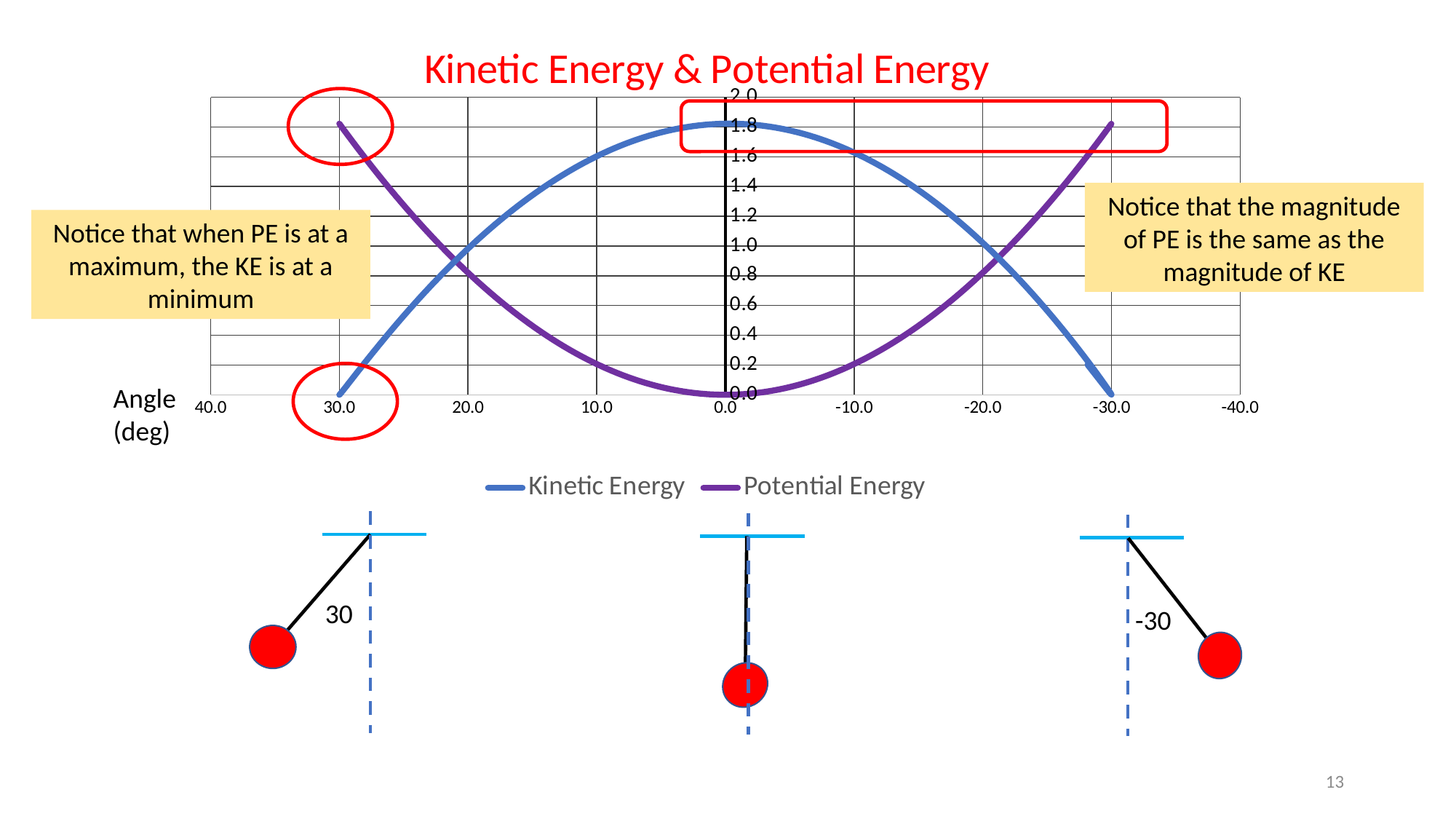
What is the Potential Energy value at an angle of 0.0? 0.0 What are the two series named in the legend? Kinetic Energy and Potential Energy Is the Potential Energy value at 30.0 greater or less than 1.6? greater Is the Kinetic Energy value at 0.0 greater or less than 1.6? greater At an angle of 10.0, which series has the larger value, Kinetic Energy or Potential Energy? Kinetic Energy Is the Kinetic Energy value at -10.0 greater or less than 1.0? greater Does the Kinetic Energy line rise or fall as the angle goes from 30.0 to 0.0? rises How many series does the legend list? 2 What is the Kinetic Energy value at an angle of 30.0? 0.0 At an angle of -30.0, which series has the larger value, Kinetic Energy or Potential Energy? Potential Energy At which angle is the Potential Energy at its lowest? 0.0 What kind of chart is shown on the slide? line chart